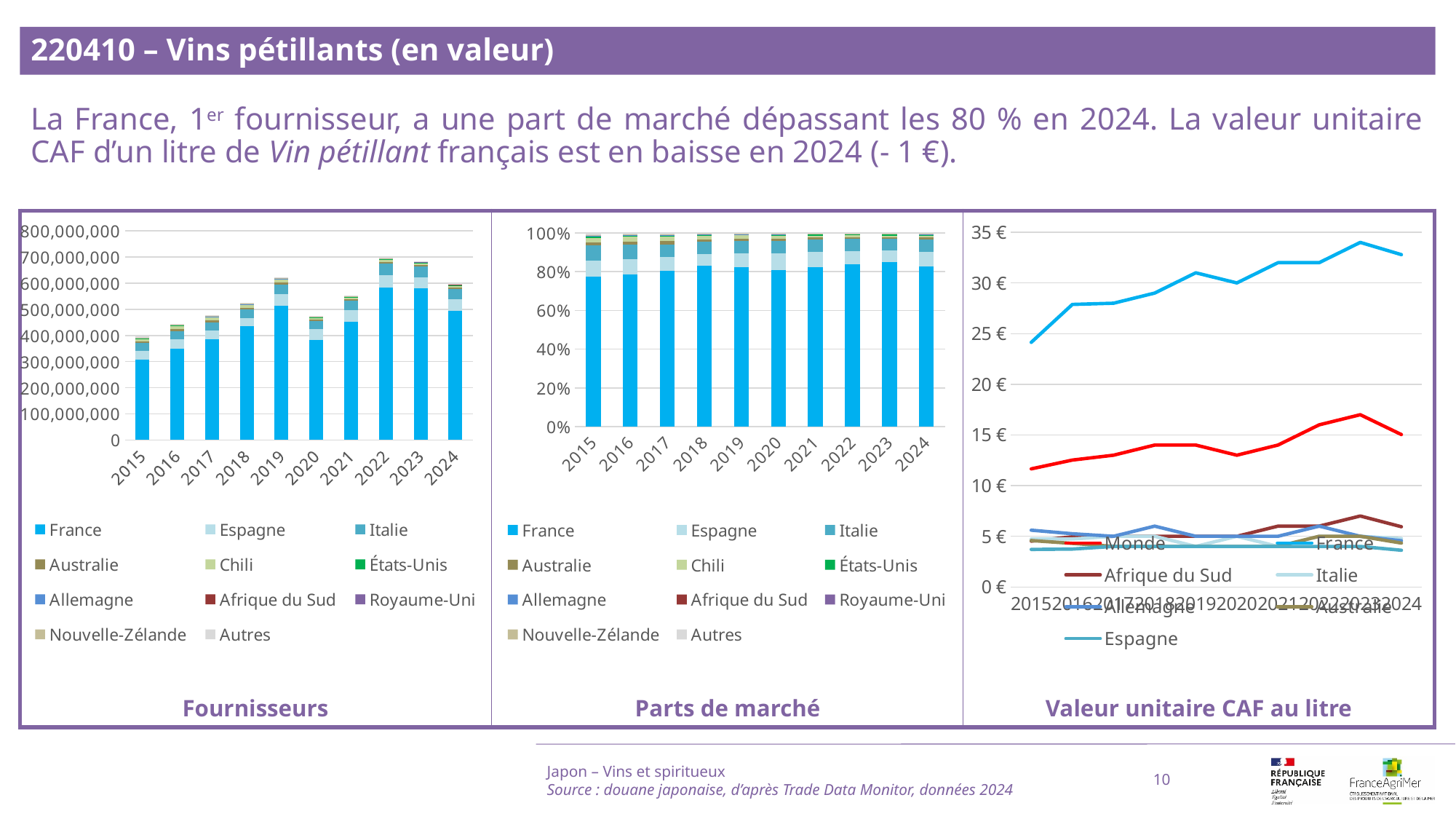
In the 'Parts de marché' chart, is the France share for 2024 greater or less than 80%? greater How many series does the legend of the 'Parts de marché' chart list? 11 In the 'Valeur unitaire CAF au litre' chart, in which year does the France line reach its highest value? 2023 In the 'Fournisseurs' chart, is the France value for 2022 greater or less than 500,000,000? greater In the 'Fournisseurs' chart, which year has the lowest total bar? 2015 In the 'Fournisseurs' chart, which total bar is larger, 2022 or 2020? 2022 What kind of chart is the 'Valeur unitaire CAF au litre' chart? line chart In the 'Valeur unitaire CAF au litre' chart, is the Monde value for 2023 greater or less than 15 €? greater In the 'Fournisseurs' chart, how many years are shown on the x axis? 10 What kind of chart is the 'Fournisseurs' chart? stacked bar chart How many series does the legend of the 'Valeur unitaire CAF au litre' chart list? 7